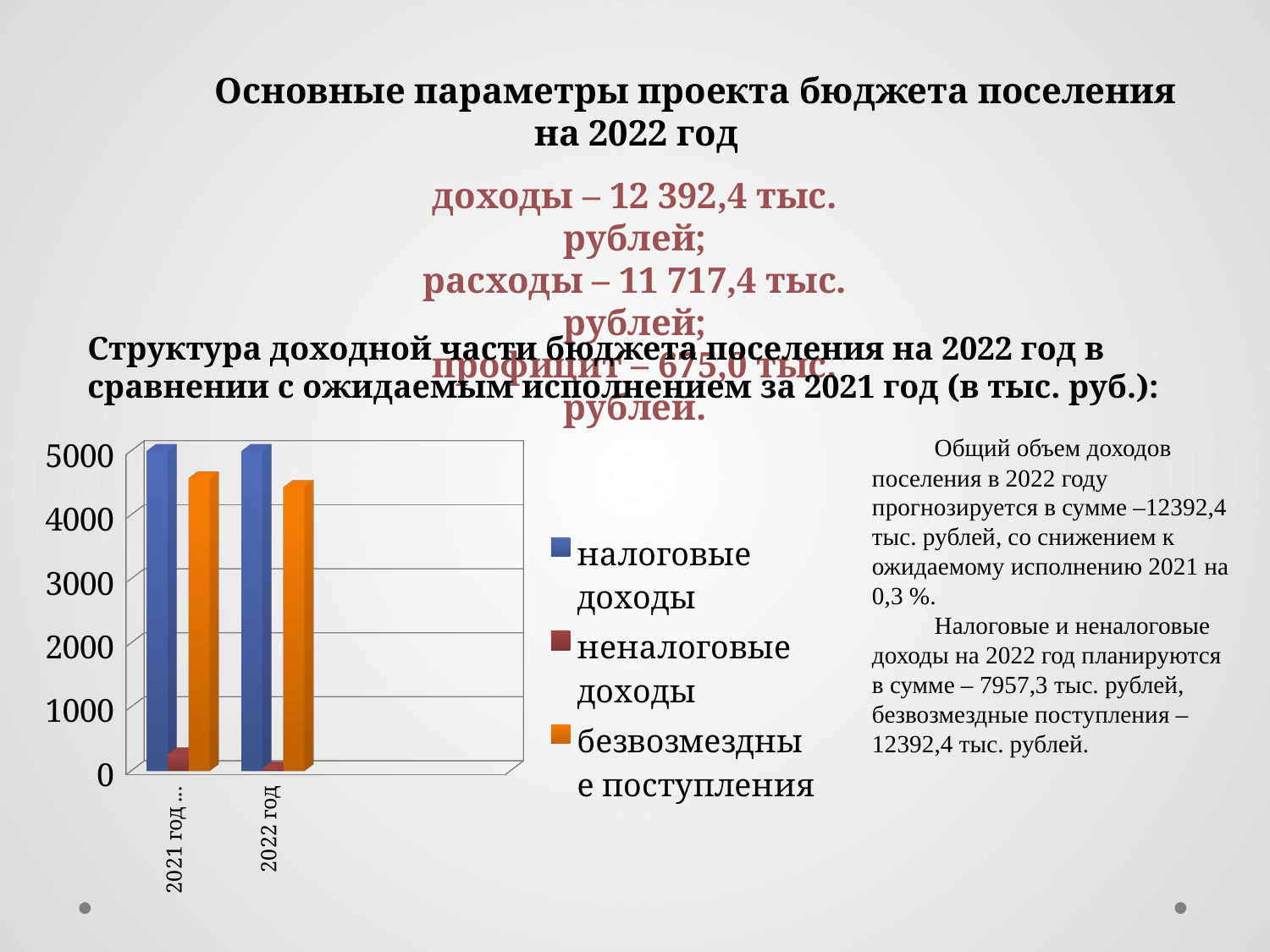
What colour represents безвозмездные поступления in the chart legend? orange Which series has the lowest value in 2022 год? неналоговые доходы In 2022 год, which is larger: налоговые доходы or неналоговые доходы? налоговые доходы Is the value for неналоговые доходы in 2022 год greater or less than 1000? less What kind of chart is shown on the slide? bar chart Is the value for безвозмездные поступления in 2022 год greater or less than 4000? greater Is the value for налоговые доходы in 2021 год greater or less than 4000? greater Does the value for неналоговые доходы rise or fall from 2021 год to 2022 год? fall How many year categories are shown on the x axis of the chart? 2 How many series does the chart legend list? 3 Which series has the highest value in 2022 год? налоговые доходы